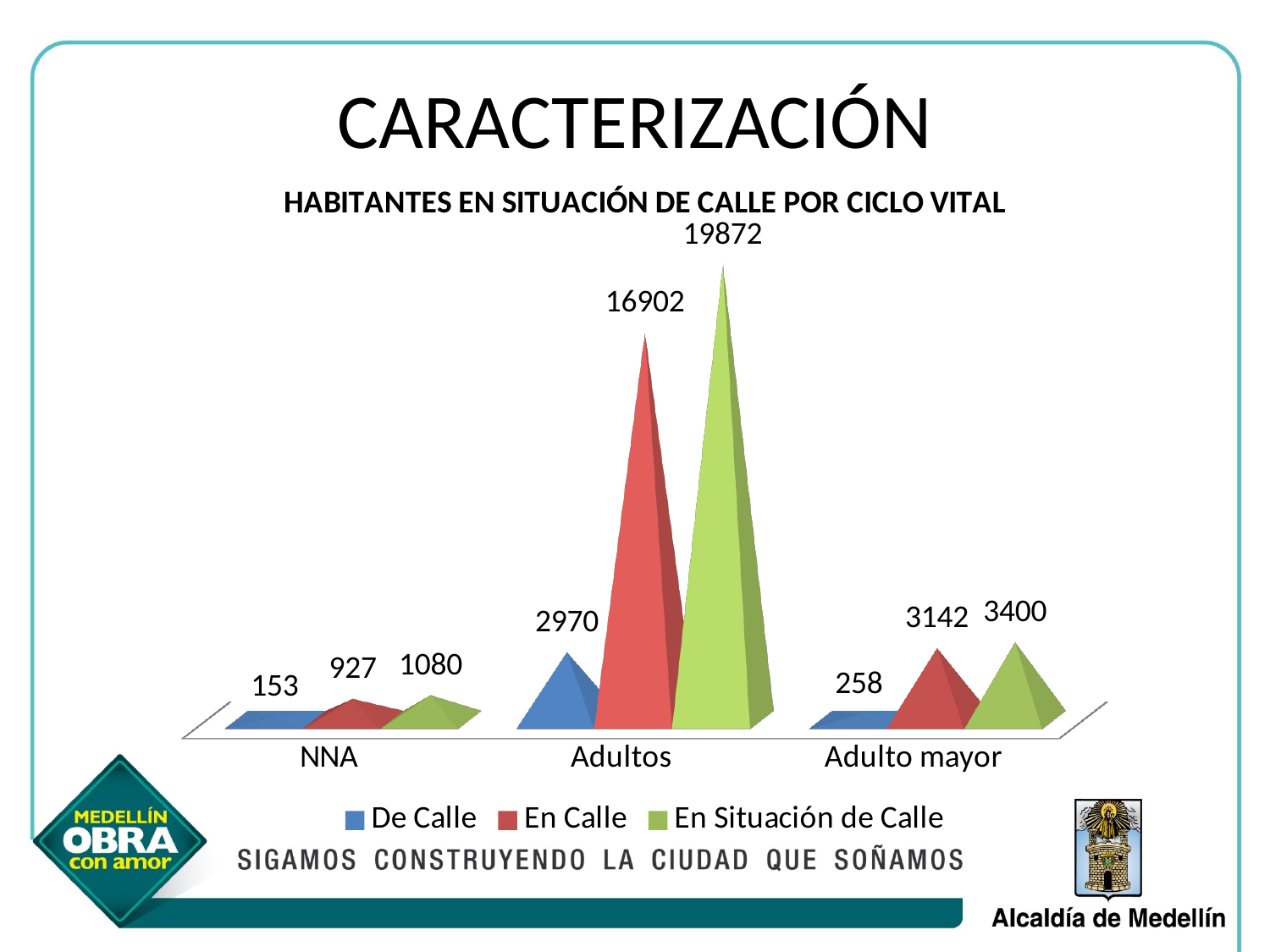
How many categories are shown on the x axis? 3 What is the value for De Calle in the NNA category? 153 How many series does the legend list? 3 What is the difference between En Situación de Calle and En Calle in the Adultos category? 2970 What is the value for En Calle in the Adultos category? 16902 Which category has the highest value for En Situación de Calle? Adultos What is the difference between En Calle and De Calle in the Adulto mayor category? 2884 Which is larger: De Calle for Adultos or En Calle for Adulto mayor? En Calle for Adulto mayor What kind of chart is shown on the slide? Bar chart What is the title of the chart? HABITANTES EN SITUACIÓN DE CALLE POR CICLO VITAL Which category has the lowest value for De Calle? NNA What is the value for En Situación de Calle in the Adulto mayor category? 3400